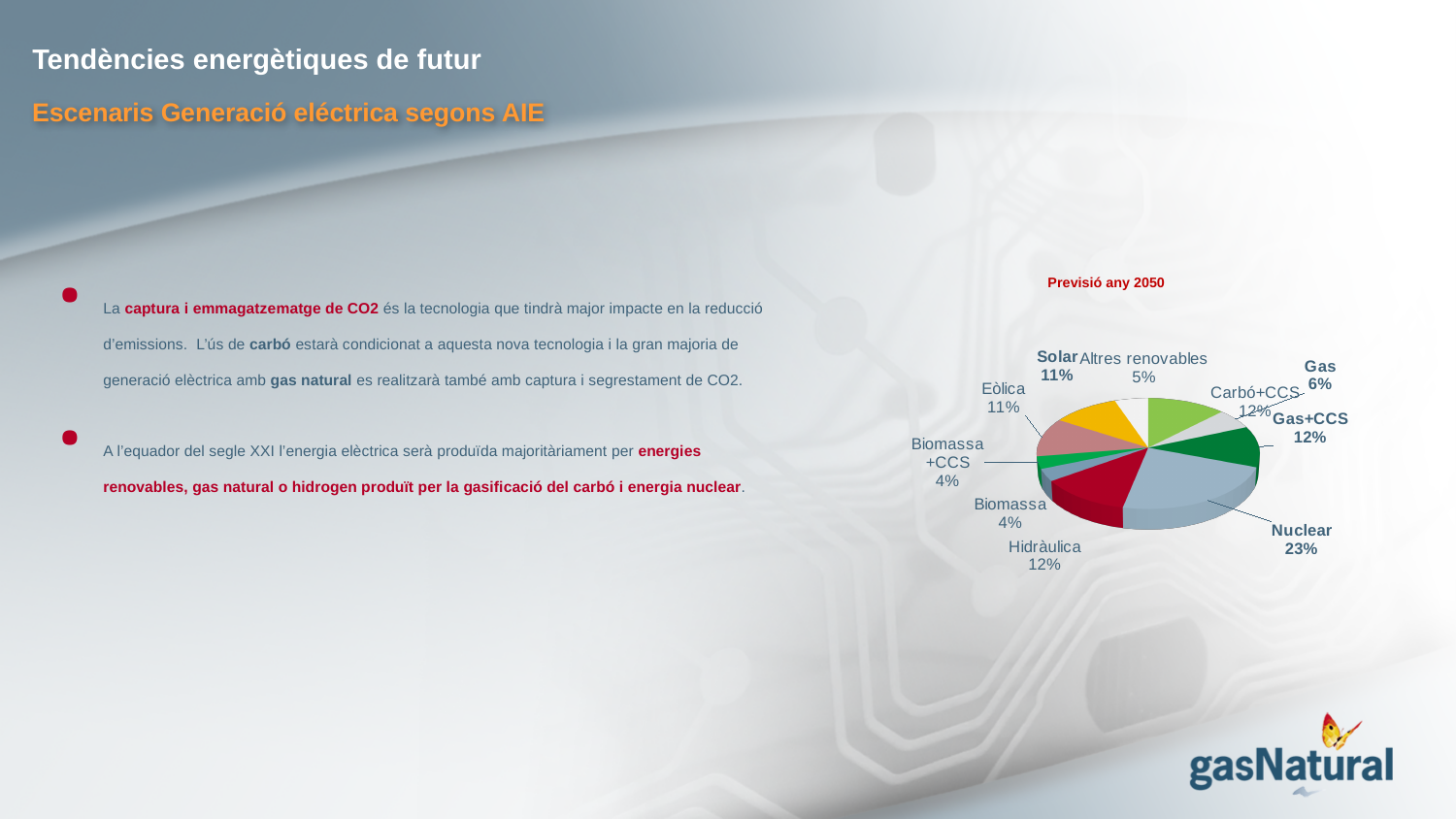
What is the combined share of Gas and Gas+CCS? 18% What is the difference between the Nuclear share and the Eòlica share? 12% Which category has the largest slice of the pie? Nuclear What share of the pie does Nuclear have? 23% What is the value shown for Biomassa+CCS? 4% How many slices does the pie chart have? 10 What kind of chart is shown on the slide? pie chart What is the title of the chart? Previsió any 2050 What is the value shown for Solar? 11% What is the value shown for Altres renovables? 5% Which is larger, the slice for Gas or the slice for Hidràulica? Hidràulica What is the value shown for Gas+CCS? 12%